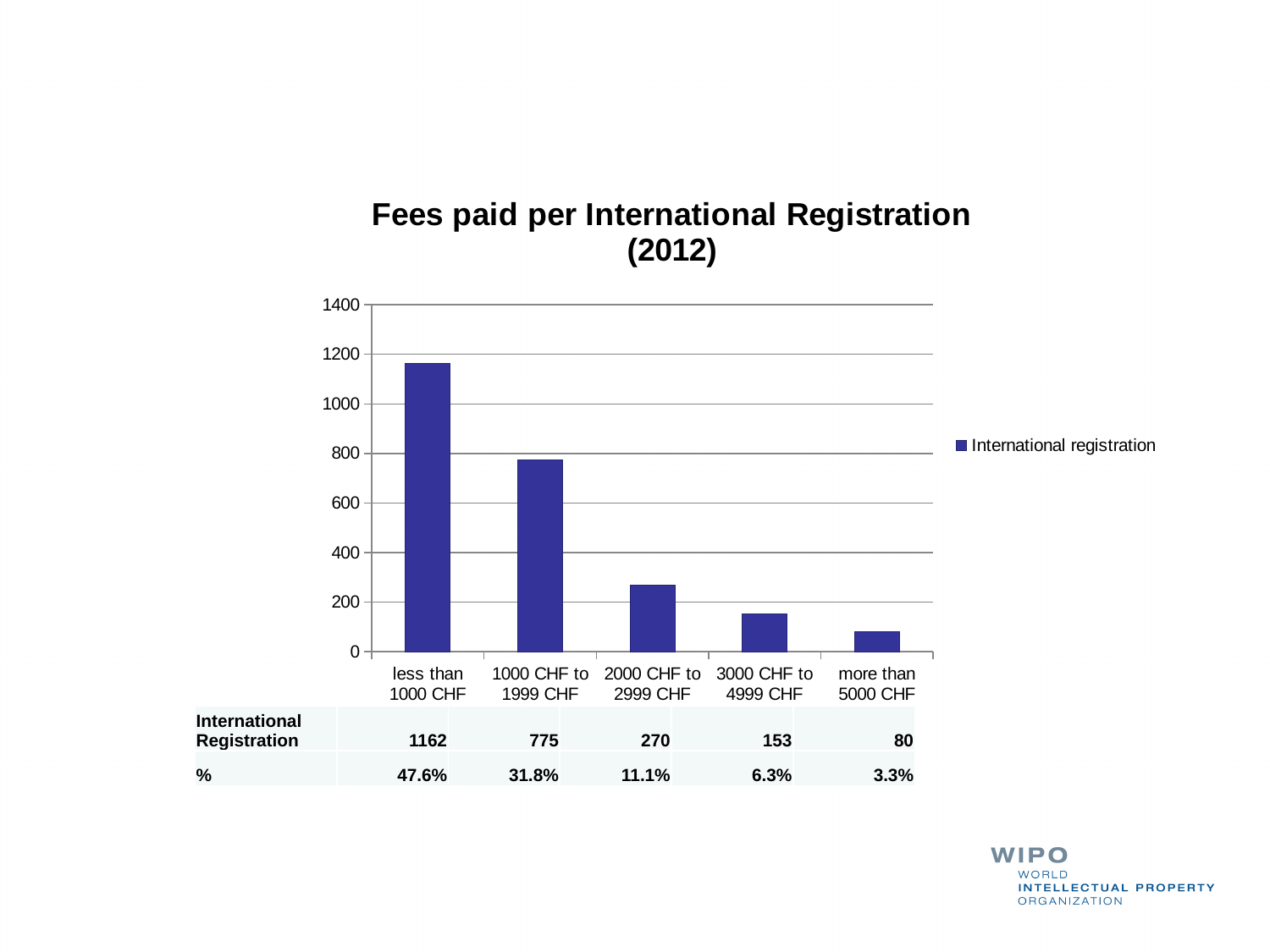
Which fee category has the highest number of international registrations? less than 1000 CHF What is the difference between the number of international registrations with fees of less than 1000 CHF and those with fees of 1000 CHF to 1999 CHF? 387 How many series does the legend list? 1 Is the value for 1000 CHF to 1999 CHF greater or less than 800? less How many fee categories are shown on the chart? 5 Do the values rise or fall as the fee categories increase along the x axis? fall What is the number of international registrations with fees of less than 1000 CHF? 1162 What is the number of international registrations with fees of 2000 CHF to 2999 CHF? 270 Which fee category has the lowest number of international registrations? more than 5000 CHF What kind of chart is shown on the slide? bar chart Which has more international registrations: the 3000 CHF to 4999 CHF category or the more than 5000 CHF category? 3000 CHF to 4999 CHF What percentage of international registrations paid fees of 1000 CHF to 1999 CHF? 31.8%